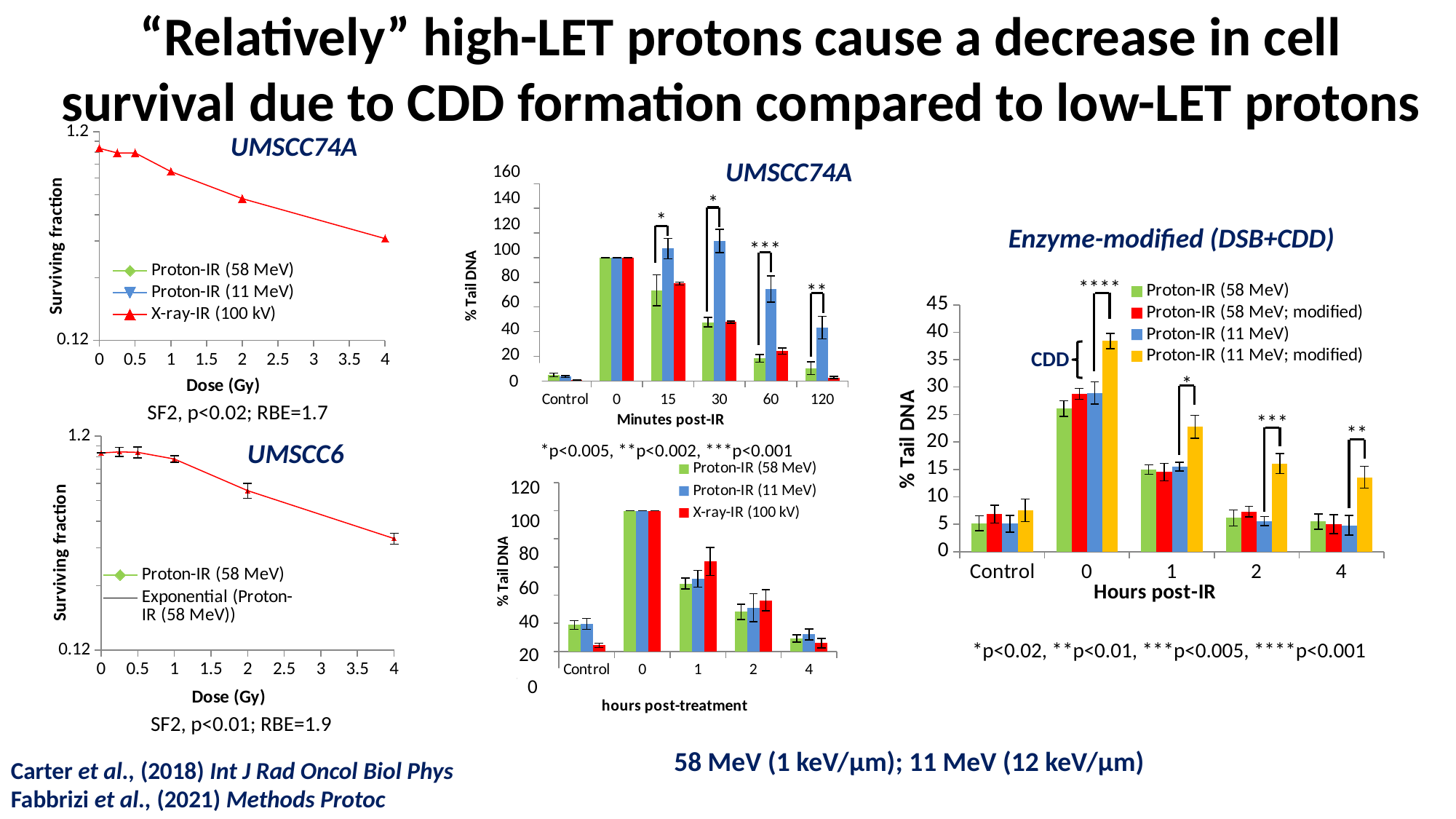
In the 'Enzyme-modified (DSB+CDD)' chart, at which time point is the Proton-IR (11 MeV; modified) bar highest? 0 In the top-left UMSCC74A surviving fraction chart, does the X-ray-IR (100 kV) surviving fraction rise or fall as dose increases? fall In the UMSCC74A '% Tail DNA' chart with Minutes post-IR on the x axis, is the Proton-IR (11 MeV) value at 30 minutes greater or less than 100? greater In the UMSCC74A '% Tail DNA' chart with Minutes post-IR on the x axis, at 120 minutes, which is larger: Proton-IR (11 MeV) or X-ray-IR (100 kV)? Proton-IR (11 MeV) In the 'Enzyme-modified (DSB+CDD)' chart, at 1 hour post-IR, which is larger: Proton-IR (11 MeV; modified) or Proton-IR (58 MeV)? Proton-IR (11 MeV; modified) In the 'Enzyme-modified (DSB+CDD)' chart, is the Proton-IR (11 MeV; modified) value at 0 hours greater or less than 35? greater In the 'Enzyme-modified (DSB+CDD)' chart, how many series does the legend list? 4 In the 'Enzyme-modified (DSB+CDD)' chart, how many categories are shown on the Hours post-IR axis? 5 What kind of chart is the 'Enzyme-modified (DSB+CDD)' chart on the right? bar chart In the '% Tail DNA' chart with hours post-treatment on the x axis, is the Proton-IR (58 MeV) value at 0 hours greater or less than 80? greater In the UMSCC74A '% Tail DNA' chart with Minutes post-IR on the x axis, how many categories are shown on the x axis? 6